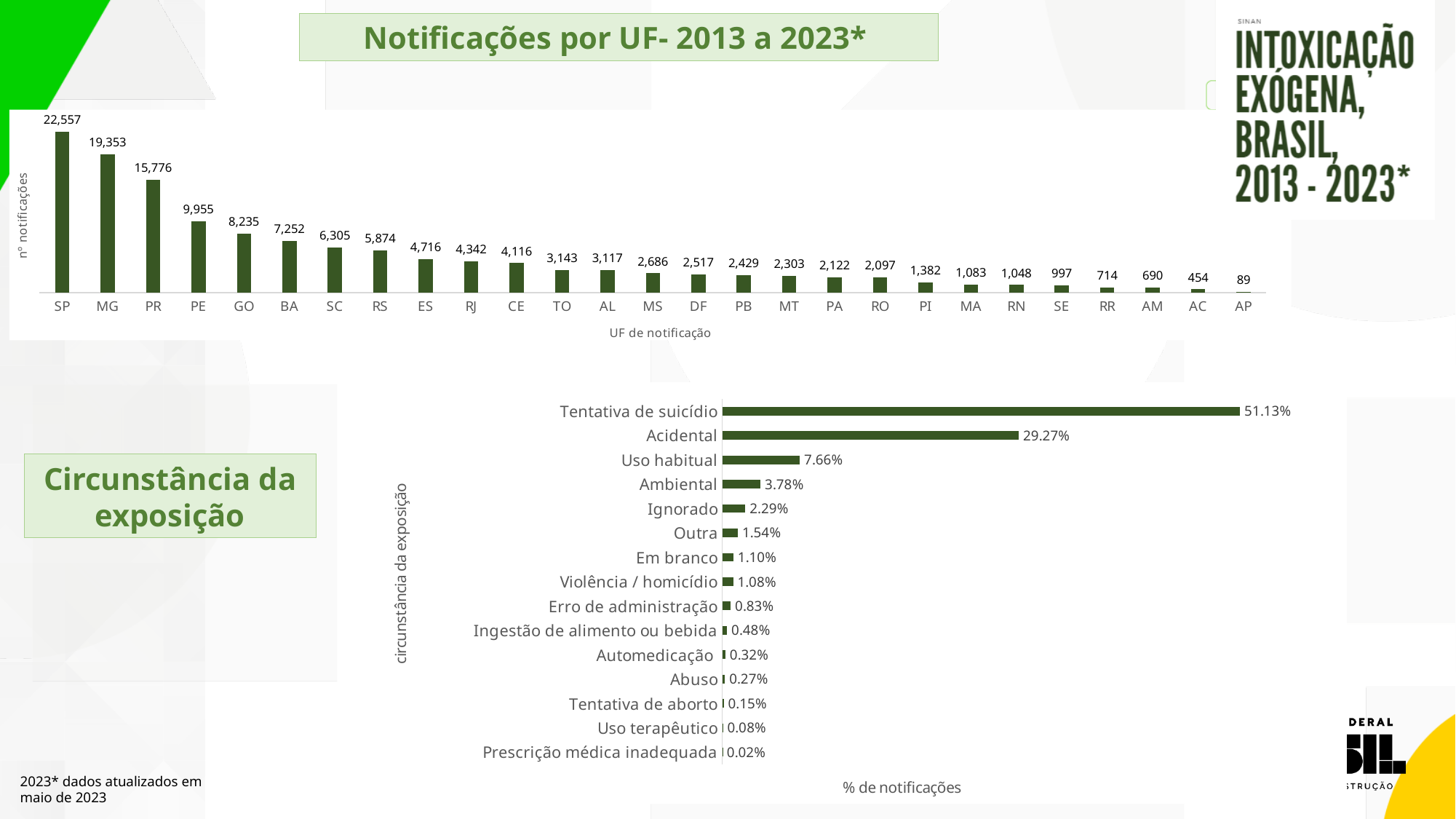
In the 'Circunstância da exposição' chart, how many categories are listed? 15 What kind of chart is the 'Circunstância da exposição' chart? bar chart In the 'Circunstância da exposição' chart, what is the value for Acidental? 29.27% In the 'Circunstância da exposição' chart, which category has the highest percentage? Tentativa de suicídio In the 'Notificações por UF- 2013 a 2023*' chart, do the values rise or fall from left to right along the x axis? fall In the 'Circunstância da exposição' chart, what is the difference between Tentativa de suicídio and Acidental? 21.86% In the 'Notificações por UF- 2013 a 2023*' chart, which UF has the lowest number of notifications? AP In the 'Notificações por UF- 2013 a 2023*' chart, which is larger, the value for RJ or the value for CE? RJ In the 'Notificações por UF- 2013 a 2023*' chart, what is the value for SP? 22,557 In the 'Notificações por UF- 2013 a 2023*' chart, what is the difference between SP and MG? 3,204 In the 'Notificações por UF- 2013 a 2023*' chart, what is the value for BA? 7,252 In the 'Notificações por UF- 2013 a 2023*' chart, how many UFs are shown? 27